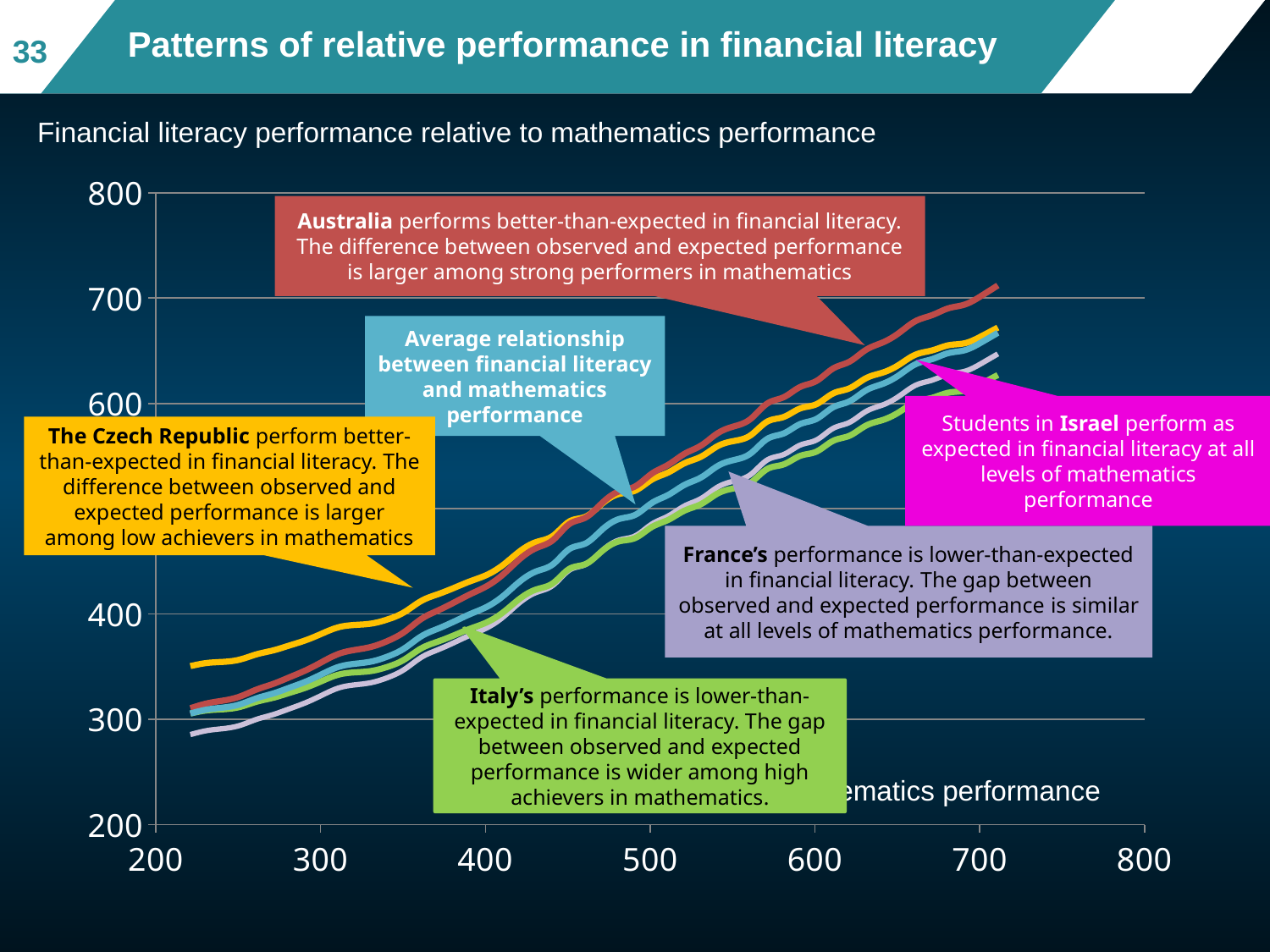
Which country's line is lowest at the low end of mathematics performance (around 300)? France Is the Czech Republic's financial literacy value at a mathematics performance of 300 greater or less than 300? greater How many lines are plotted on the chart? 6 At a mathematics performance of 300, which line is higher: the Czech Republic or France? The Czech Republic What is the highest value shown on the y axis? 800 What kind of chart is shown on the slide? line chart Which country's line is highest at the low end of mathematics performance (around 300)? The Czech Republic Do the lines rise or fall as mathematics performance increases along the x axis? rise Is the Czech Republic's financial literacy value at a mathematics performance of 300 greater or less than 400? less Is Australia's financial literacy value at a mathematics performance of 700 greater or less than 600? greater What is the title of the chart? Financial literacy performance relative to mathematics performance